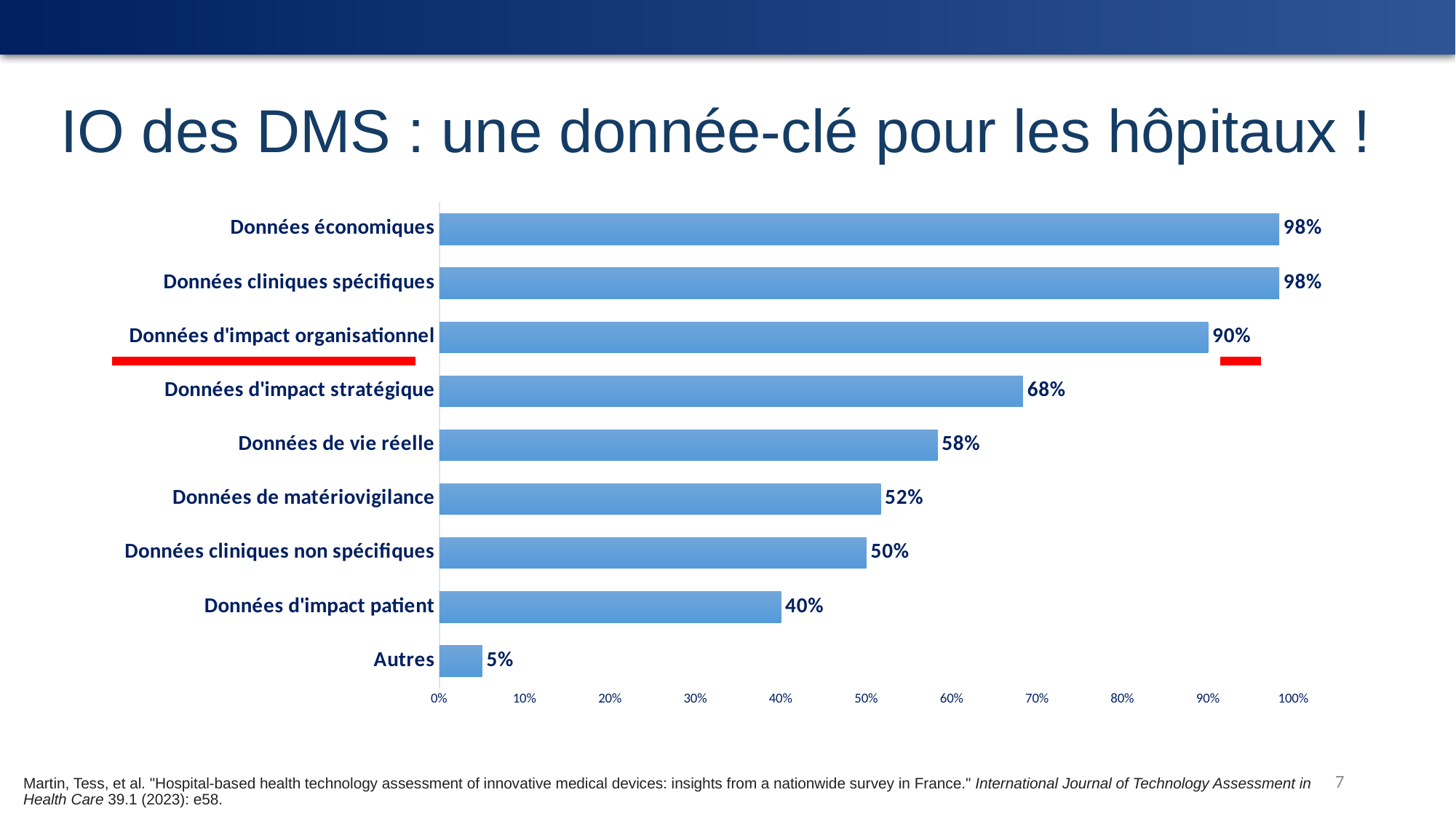
Which category is underlined in red on the slide? Données d'impact organisationnel How many categories are shown in the chart? 9 What is the value for Autres? 5% Which is larger, Données de vie réelle or Données d'impact patient? Données de vie réelle Which category has the lowest value? Autres Is the value for Données d'impact stratégique greater or less than 60%? greater What is the value for Données d'impact organisationnel? 90% What is the difference between Données d'impact organisationnel and Données d'impact stratégique? 22% What is the value for Données d'impact patient? 40% What is the difference between Données de matériovigilance and Données cliniques non spécifiques? 2% What is the value for Données de vie réelle? 58% What kind of chart is shown on the slide? bar chart